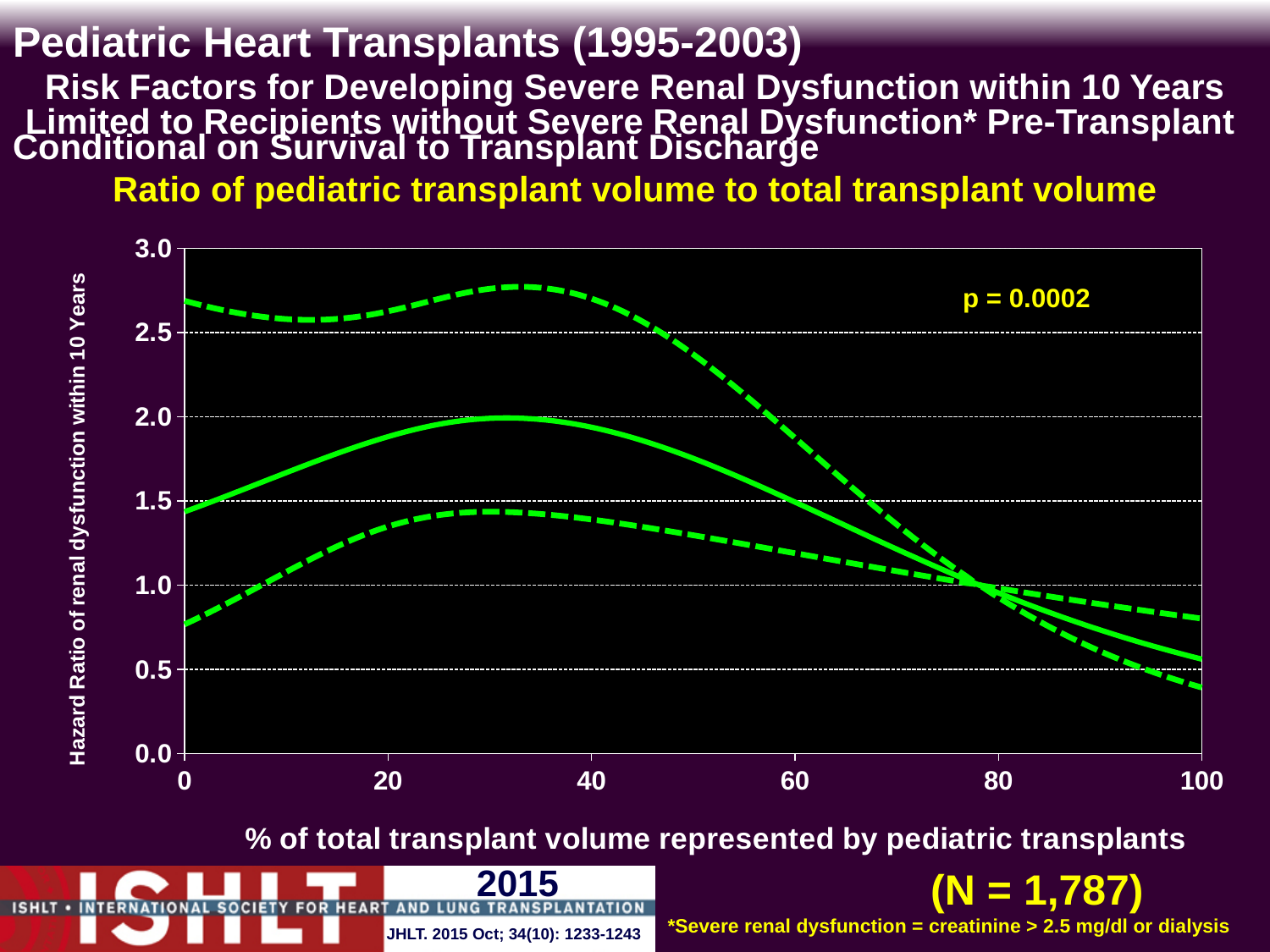
Is the value of the solid line at 20% of total transplant volume greater or less than 1.5? greater Is the value of the upper dashed line at 0% of total transplant volume greater or less than 2.5? greater How many lines are plotted on the chart? 3 What kind of chart is shown on the slide? line chart Is the value of the lower dashed line at 0% of total transplant volume greater or less than 1.0? less What is the N shown on the slide? N = 1,787 Is the solid line higher or lower at 100% than at 0% of total transplant volume? lower Is the solid line higher at 20% or at 80% of total transplant volume? 20% Between 40% and 100% of total transplant volume, does the solid line rise or fall? fall What p-value is shown on the chart? p = 0.0002